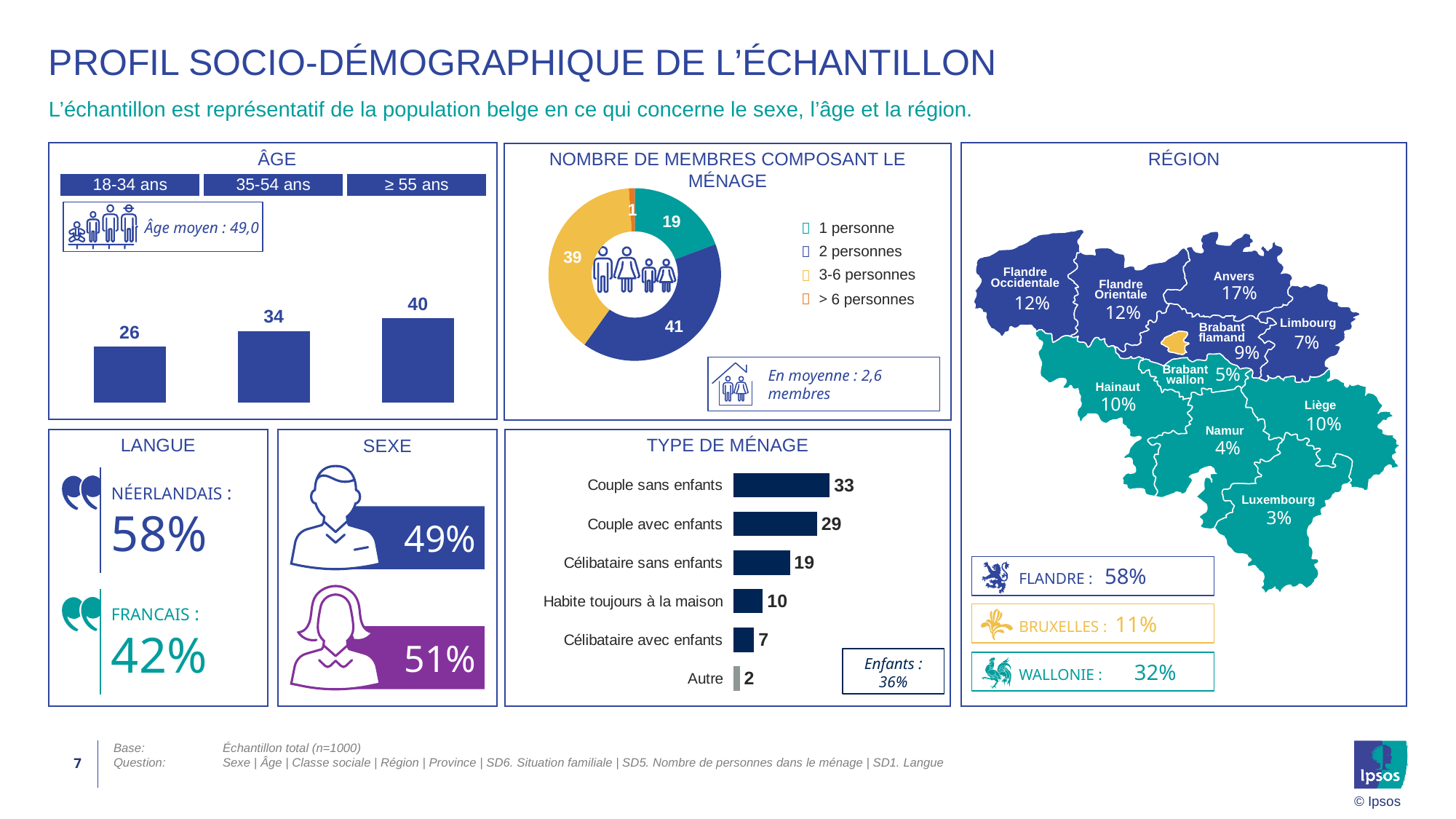
In the TYPE DE MÉNAGE chart, what is the value for Célibataire sans enfants? 19 In the TYPE DE MÉNAGE chart, which is larger: Habite toujours à la maison or Célibataire avec enfants? Habite toujours à la maison In the NOMBRE DE MEMBRES COMPOSANT LE MÉNAGE chart, what is the value for 2 personnes? 41 How many categories are shown in the TYPE DE MÉNAGE chart? 6 What kind of chart is the NOMBRE DE MEMBRES COMPOSANT LE MÉNAGE chart? donut chart In the ÂGE chart, what is the difference between the ≥ 55 ans and 18-34 ans values? 14 What kind of chart is the ÂGE chart? bar chart In the ÂGE chart, what is the value for the 35-54 ans category? 34 How many categories does the legend of the NOMBRE DE MEMBRES COMPOSANT LE MÉNAGE chart list? 4 In the NOMBRE DE MEMBRES COMPOSANT LE MÉNAGE chart, which category has the smallest value? > 6 personnes In the TYPE DE MÉNAGE chart, which category has the highest value? Couple sans enfants In the ÂGE chart, which age group has the highest value? ≥ 55 ans